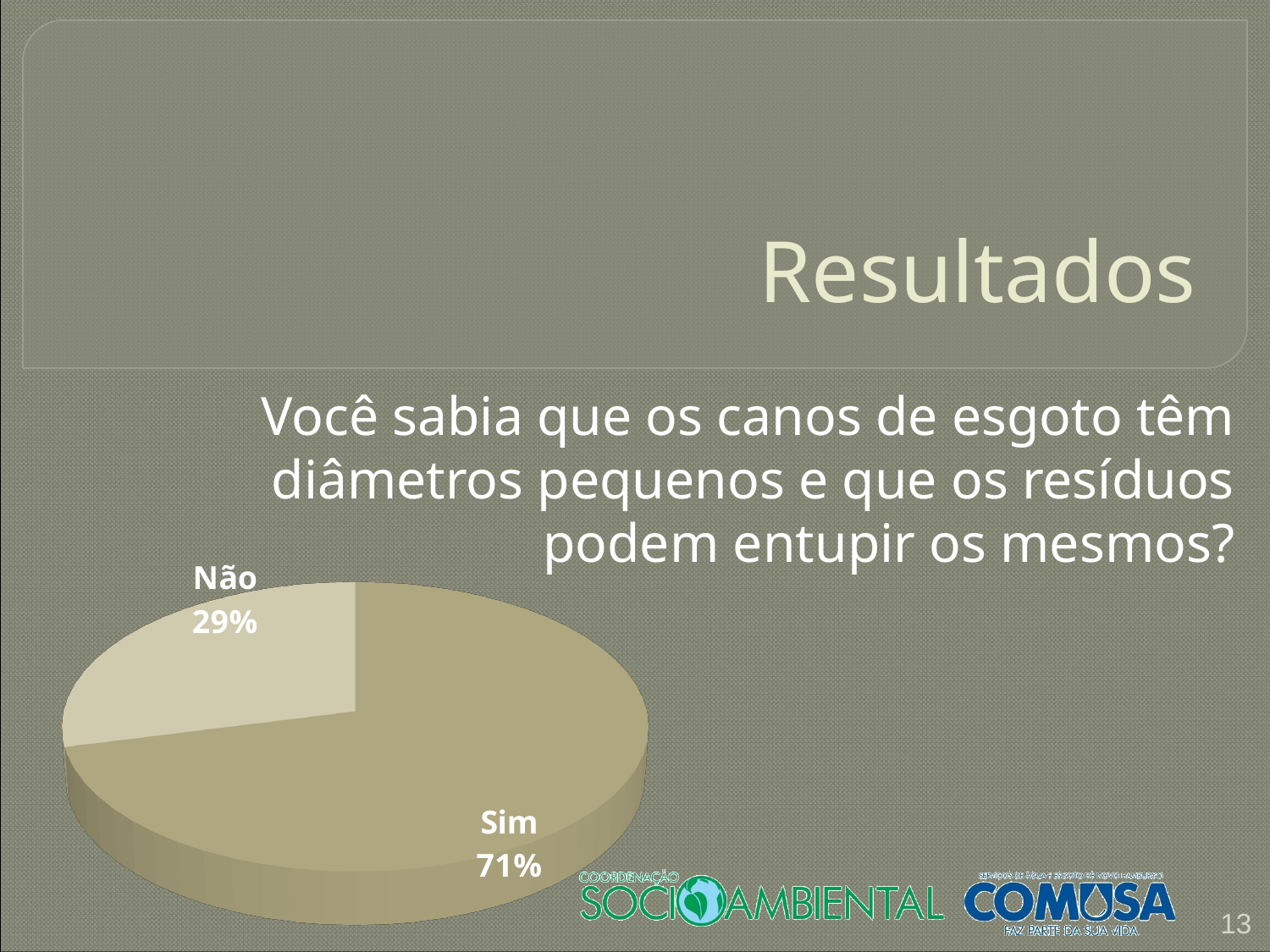
Which slice is larger, "Sim" or "Não"? Sim Which response has the smallest share of the pie? Não What question do the pie chart results answer? Você sabia que os canos de esgoto têm diâmetros pequenos e que os resíduos podem entupir os mesmos? Which response has the largest share of the pie? Sim Is the share for "Sim" greater or less than 50%? greater What is the title of the slide containing the pie chart? Resultados What percentage of respondents answered "Sim"? 71% What kind of chart is shown on the slide? Pie chart What percentage of respondents answered "Não"? 29% How many slices does the pie chart have? 2 What is the difference in percentage points between the "Sim" and "Não" slices? 42 What share of the pie does the "Não" slice represent? 29%